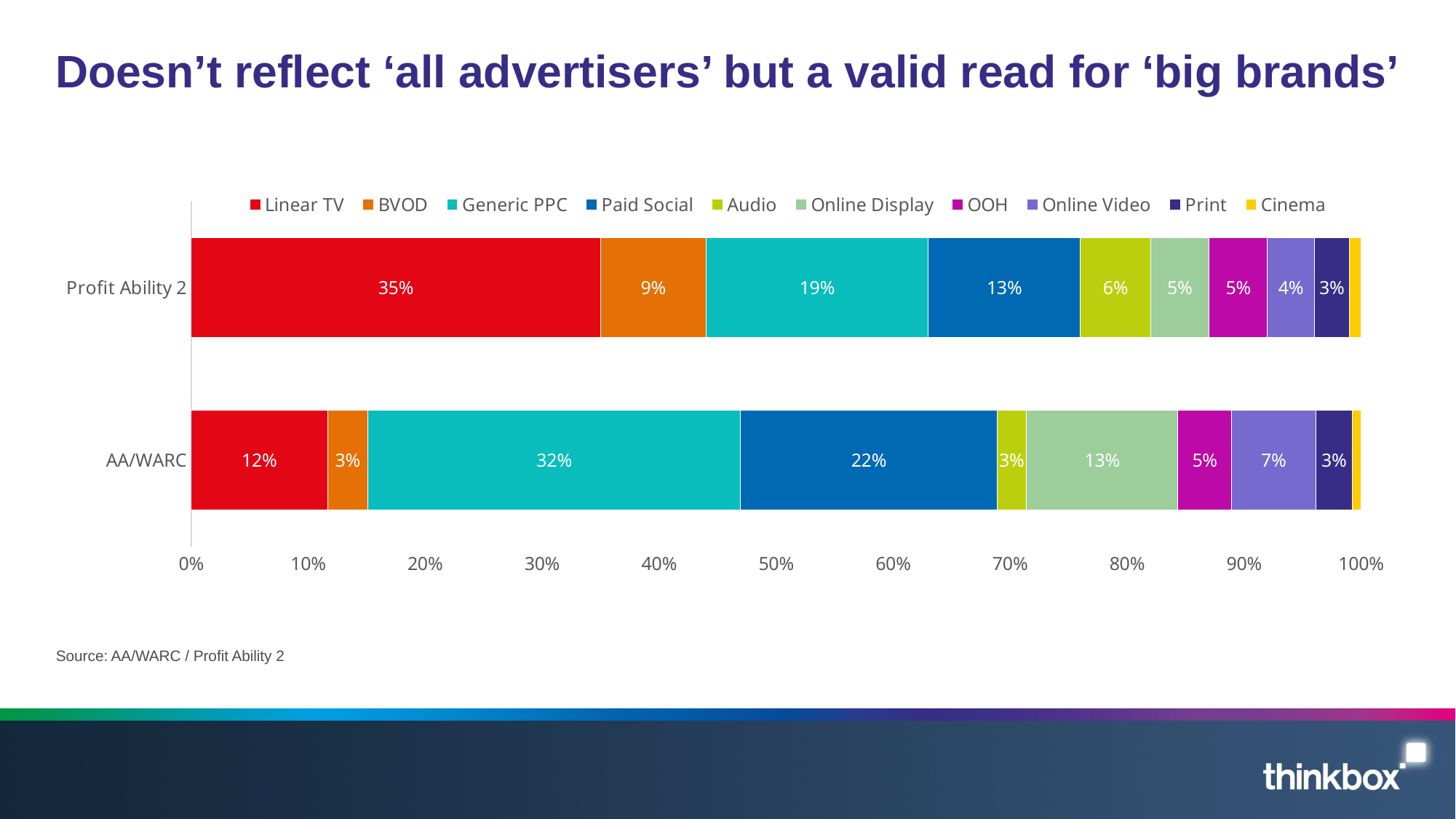
Which series has the largest segment in the Profit Ability 2 bar? Linear TV What is the Paid Social share for Profit Ability 2? 13% What is the Linear TV share for Profit Ability 2? 35% How many bars (categories) are shown on the chart? 2 How many series does the legend list? 10 What kind of chart is shown on the slide? Stacked bar chart What is the difference between the Paid Social share for AA/WARC and for Profit Ability 2? 9% What is the difference between the Linear TV share for Profit Ability 2 and for AA/WARC? 23% Which series has the largest segment in the AA/WARC bar? Generic PPC Which is larger: the BVOD share for Profit Ability 2 or for AA/WARC? Profit Ability 2 What is the Generic PPC share for AA/WARC? 32% What is the Online Display share for AA/WARC? 13%